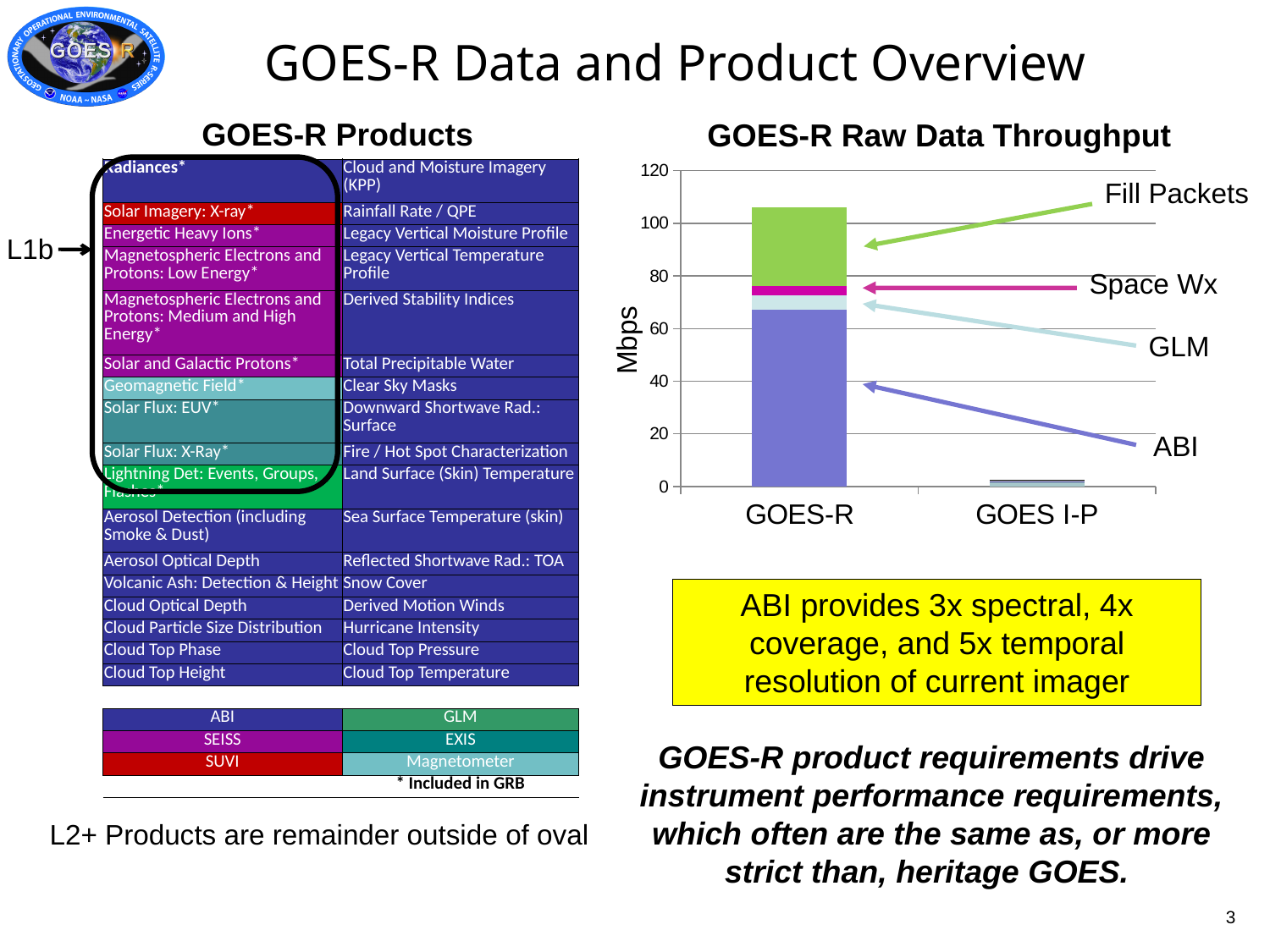
In the GOES-R Raw Data Throughput chart, is the total value for GOES-R greater or less than 100? greater In the GOES-R Raw Data Throughput chart, which category has the higher total throughput, GOES-R or GOES I-P? GOES-R What is the title of the chart on the right side of the slide? GOES-R Raw Data Throughput In the GOES-R Raw Data Throughput chart, is the Fill Packets segment of the GOES-R bar greater or less than 20? greater What is the y-axis label of the GOES-R Raw Data Throughput chart? Mbps In the GOES-R Raw Data Throughput chart, which series makes up the largest segment of the GOES-R bar? ABI In the GOES-R Raw Data Throughput chart, which category has the lowest total throughput? GOES I-P How many categories are shown on the x axis of the GOES-R Raw Data Throughput chart? 2 What type of chart is the GOES-R Raw Data Throughput chart? Stacked bar chart How many series are labeled in the GOES-R Raw Data Throughput chart? 4 In the GOES-R Raw Data Throughput chart, is the total value for GOES I-P greater or less than 20? less